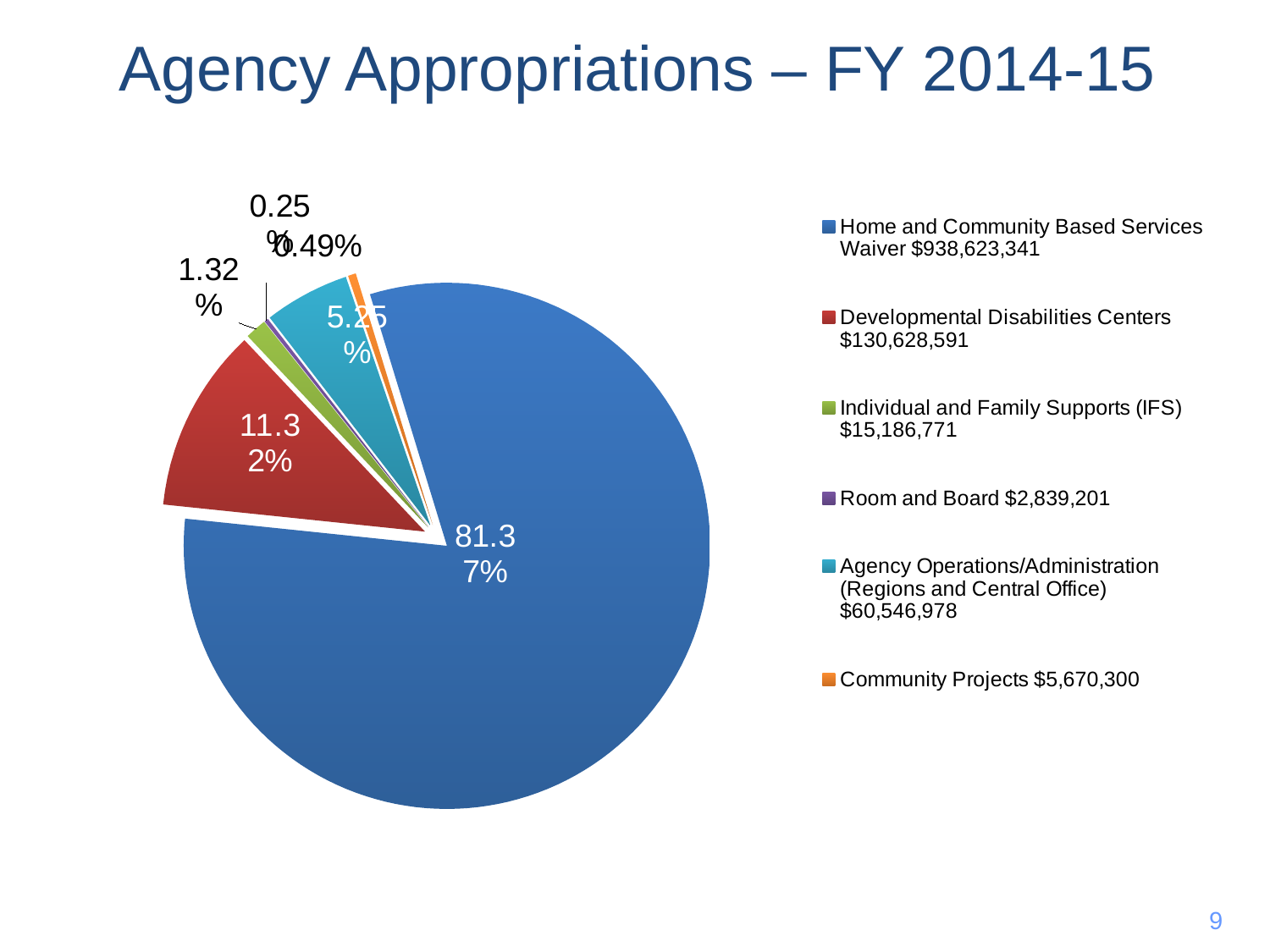
Which category has the smallest slice of the pie? Room and Board How many slices does the pie chart have? 6 What share of the pie does Room and Board represent? 0.25% How many entries does the legend list? 6 What kind of chart is shown on the slide? pie chart What is the difference in percentage points between the Home and Community Based Services Waiver slice and the Developmental Disabilities Centers slice? 70.05% Which is larger, the Agency Operations/Administration slice or the Developmental Disabilities Centers slice? Developmental Disabilities Centers Which category has the largest slice of the pie? Home and Community Based Services Waiver What share of the pie does Individual and Family Supports (IFS) represent? 1.32% What dollar amount does the legend give for Community Projects? $5,670,300 What share of the pie does Home and Community Based Services Waiver represent? 81.37%